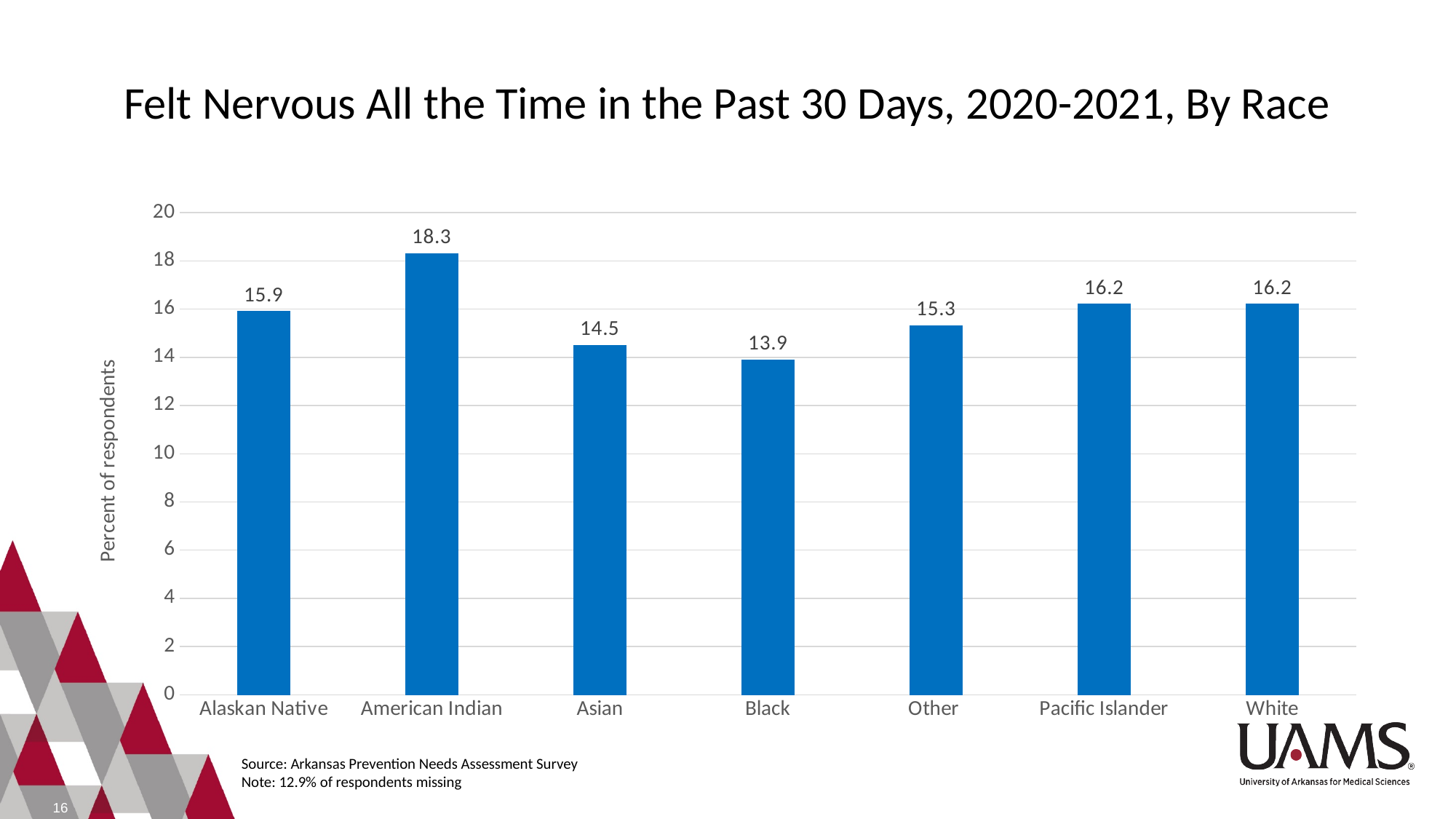
What is the difference between the values for Alaskan Native and Asian? 1.4 What is the value for Other? 15.3 Which is larger, the value for Asian or the value for Other? Other What is the value for Black? 13.9 What is the label of the vertical axis? Percent of respondents What is the value for American Indian? 18.3 Is the value for Pacific Islander greater or less than 16? greater Which race category has the lowest value? Black Which race category has the highest value? American Indian What kind of chart is shown on the slide? bar chart How many race categories are shown on the chart? 7 What is the difference between the values for American Indian and Black? 4.4